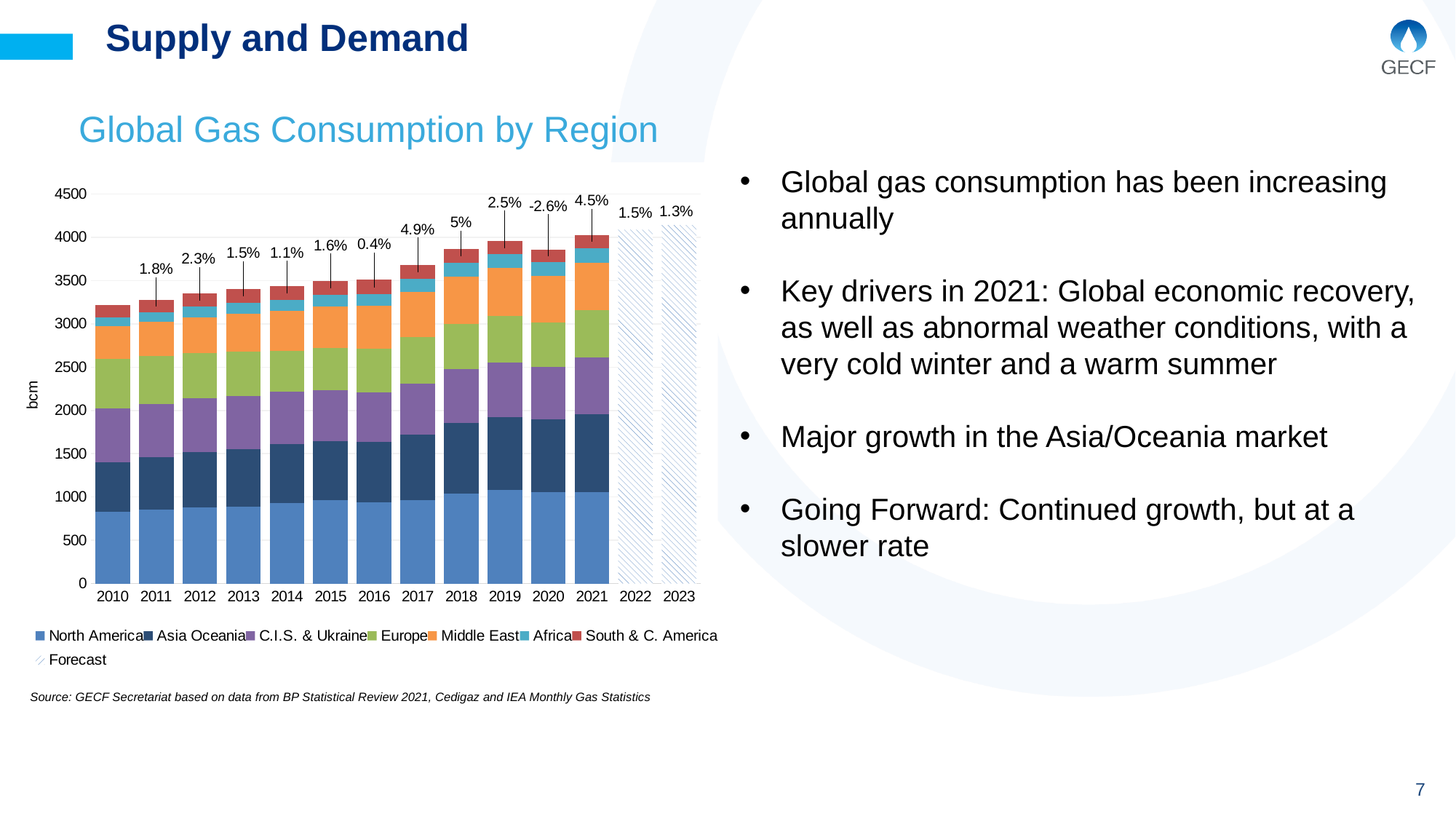
Is the total consumption for 2010 greater or less than 3500 bcm? less Which year has the lowest growth rate label on the chart? 2020 Which year has the highest growth rate label on the chart? 2018 What growth rate is labelled for the 2023 forecast bar? 1.3% What growth rate is labelled above the 2020 bar? -2.6% Which year has the larger growth rate label, 2019 or 2021? 2021 How many years are shown on the x axis? 14 Is the total consumption for 2018 greater or less than 3500 bcm? greater What kind of chart is shown on the slide? Stacked bar chart By how many percentage points does the 2017 growth label exceed the 2016 growth label? 4.5 percentage points How many regions are listed in the legend? 7 What growth rate is labelled above the 2018 bar? 5%